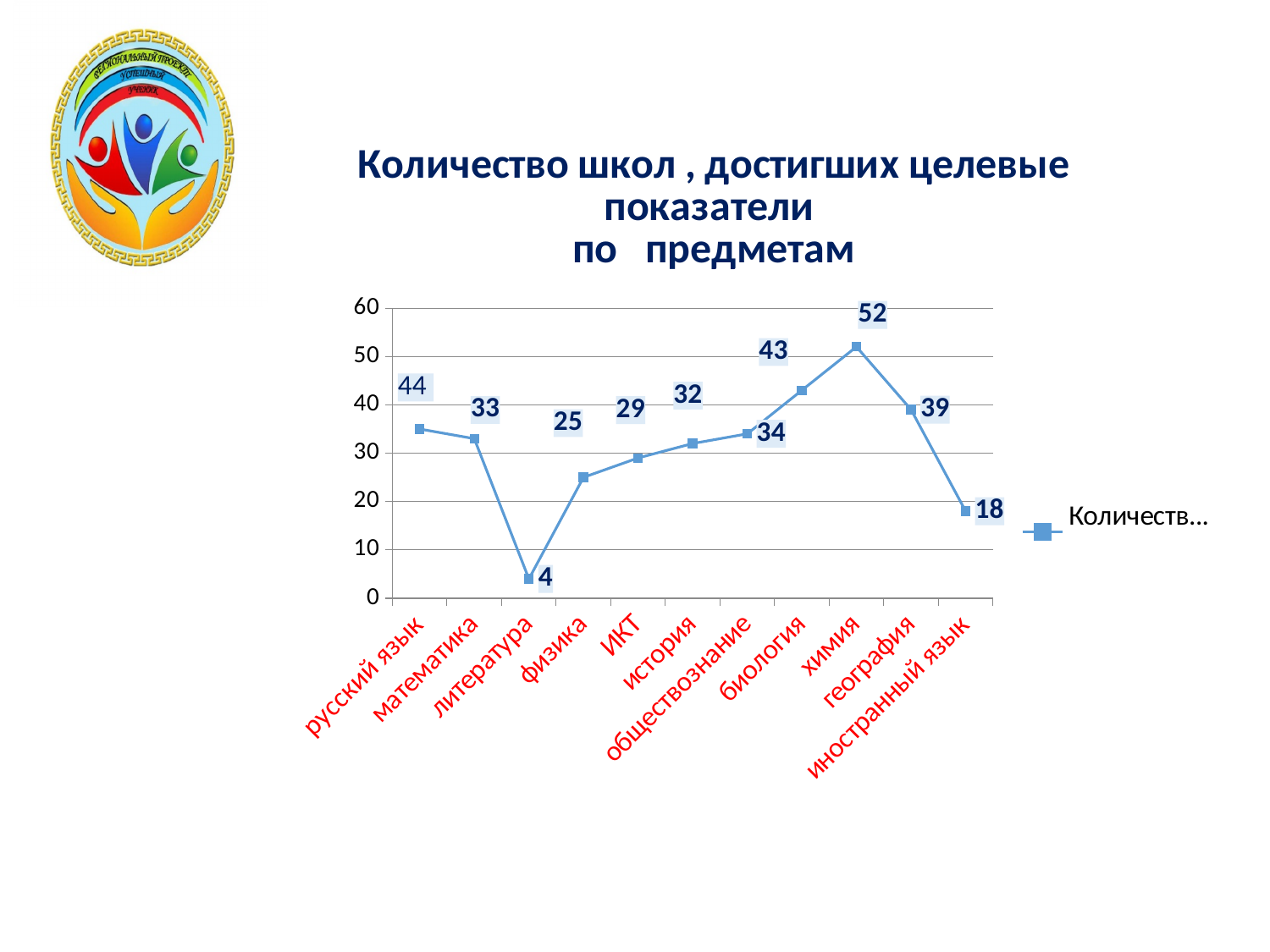
Which has a larger value, история or физика? история Which subject has the highest value? химия What is the value for химия? 52 Which subject has the lowest value? литература What is the difference between the values for химия and география? 13 What is the value for биология? 43 What is the value for иностранный язык? 18 How many series does the legend list? 1 How many subjects are shown on the x axis? 11 Is the value for обществознание greater or less than 30? greater What is the value for литература? 4 What type of chart is shown on the slide? line chart